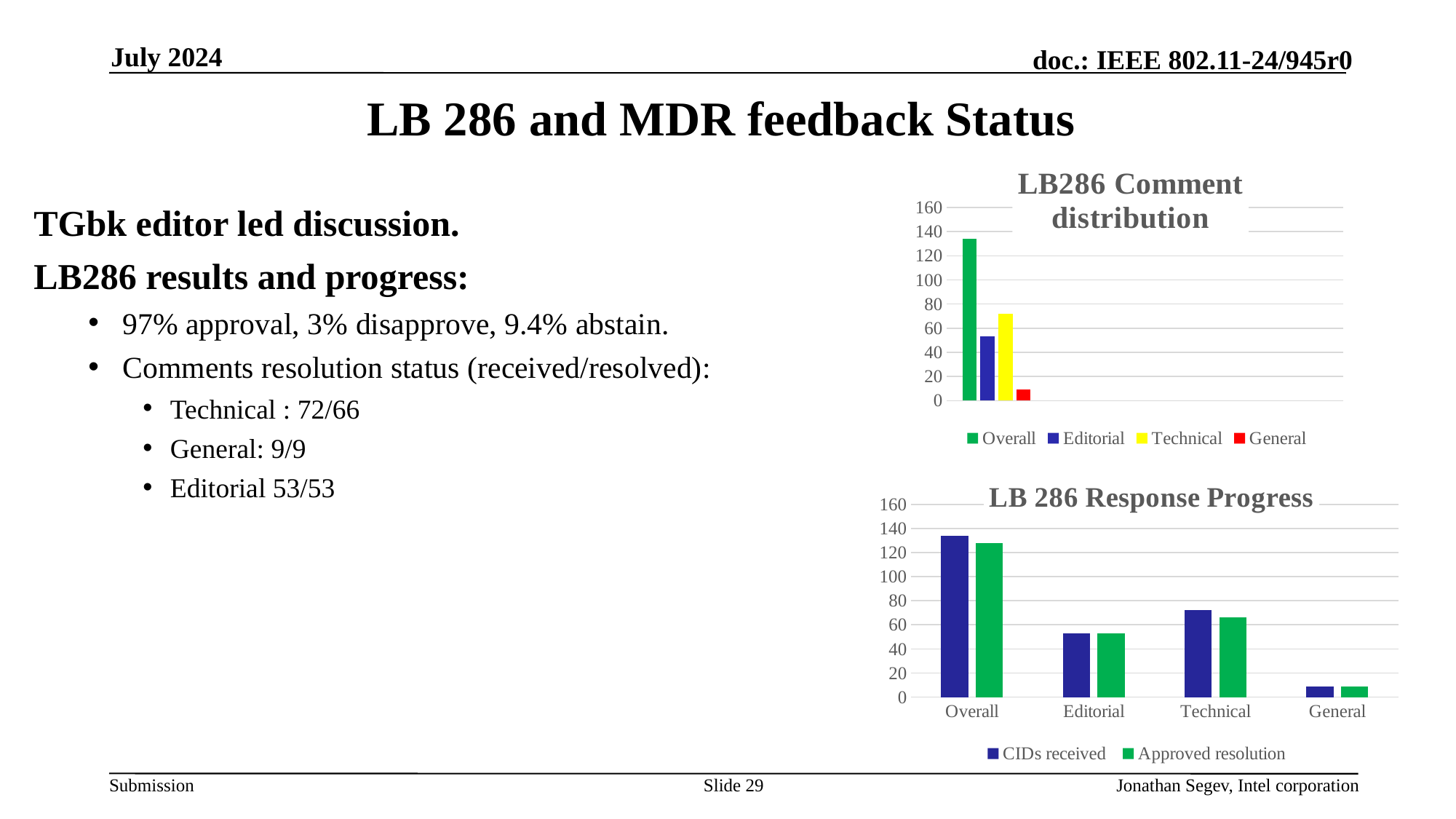
In the "LB286 Comment distribution" chart, which is larger, Technical or Editorial? Technical In the "LB 286 Response Progress" chart, is the CIDs received value for Editorial greater or less than 60? less In the "LB286 Comment distribution" chart, which series has the highest value? Overall How many series does the legend of the "LB286 Comment distribution" chart list? 4 In the "LB 286 Response Progress" chart, which category has the highest CIDs received value? Overall In the "LB286 Comment distribution" chart, is the value for Overall greater or less than 120? greater In the "LB286 Comment distribution" chart, what colour is the General bar? red How many categories are shown on the x axis of the "LB 286 Response Progress" chart? 4 In the "LB286 Comment distribution" chart, is the value for Technical greater or less than 60? greater How many series does the legend of the "LB 286 Response Progress" chart list? 2 In the "LB286 Comment distribution" chart, which series has the lowest value? General What kind of chart is the "LB286 Comment distribution" chart? bar chart